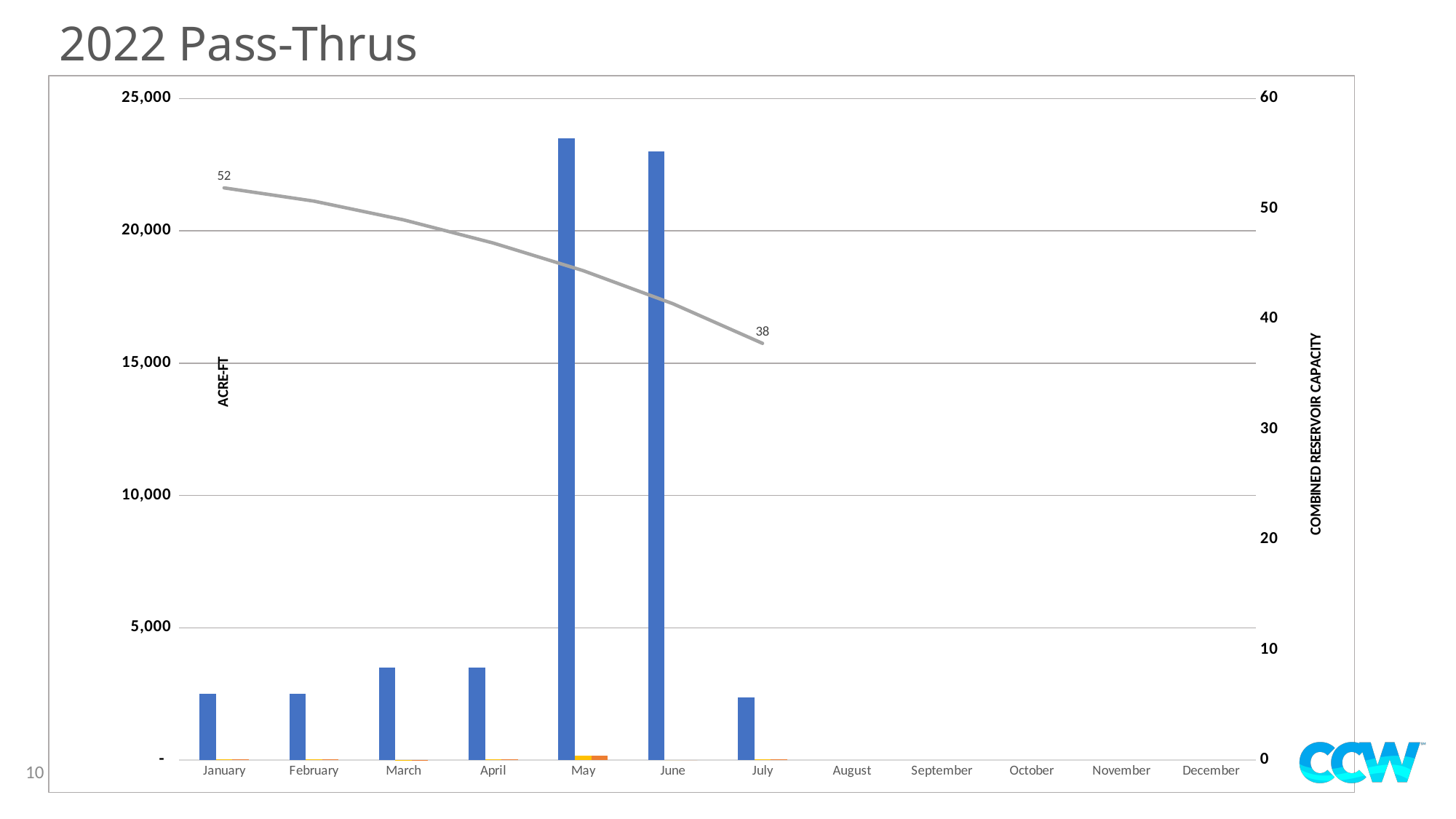
What kind of chart is shown on the slide? A bar chart with a line What is the label on the right-hand vertical axis? COMBINED RESERVOIR CAPACITY What value does the gray line show for July? 38 Which month has the tallest blue bar? May Is the blue bar for June greater or less than 20,000 acre-ft? greater By how much does the gray line value drop from January (52) to July (38)? 14 What is the title of the chart on the slide? 2022 Pass-Thrus Does the gray line rise or fall from January to July? Fall What value does the gray line show for January? 52 Is the blue bar for January greater or less than 5,000 acre-ft? less Which has the taller blue bar, January or March? March How many months are listed along the x axis? 12